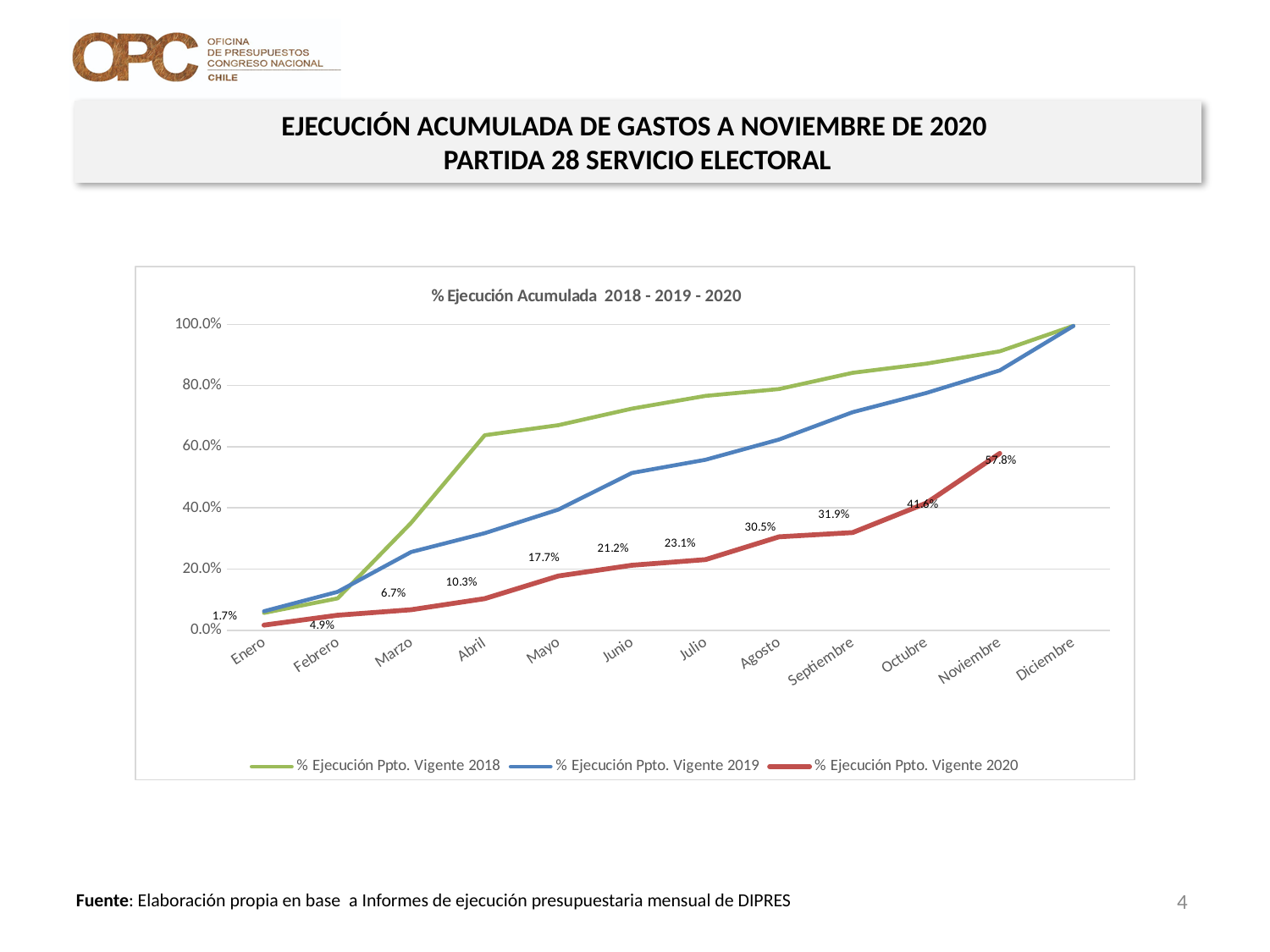
Which series has the highest value in Abril? % Ejecución Ppto. Vigente 2018 What is the value of % Ejecución Ppto. Vigente 2020 for Enero? 1.7% What is the value of % Ejecución Ppto. Vigente 2020 for Noviembre? 57.8% Is the value of % Ejecución Ppto. Vigente 2019 for Junio greater or less than 40.0%? greater Does the % Ejecución Ppto. Vigente 2020 series rise or fall from Enero to Noviembre? Rise What kind of chart is shown on the slide? Line chart What is the difference between the 2020 values for Noviembre and Octubre? 16.2% What is the value of % Ejecución Ppto. Vigente 2020 for Agosto? 30.5% What is the value of % Ejecución Ppto. Vigente 2020 for Mayo? 17.7% How many series does the chart legend list? 3 Which is larger in Septiembre: the 2019 value or the 2020 value? 2019 What is the title of the chart? % Ejecución Acumulada 2018 - 2019 - 2020